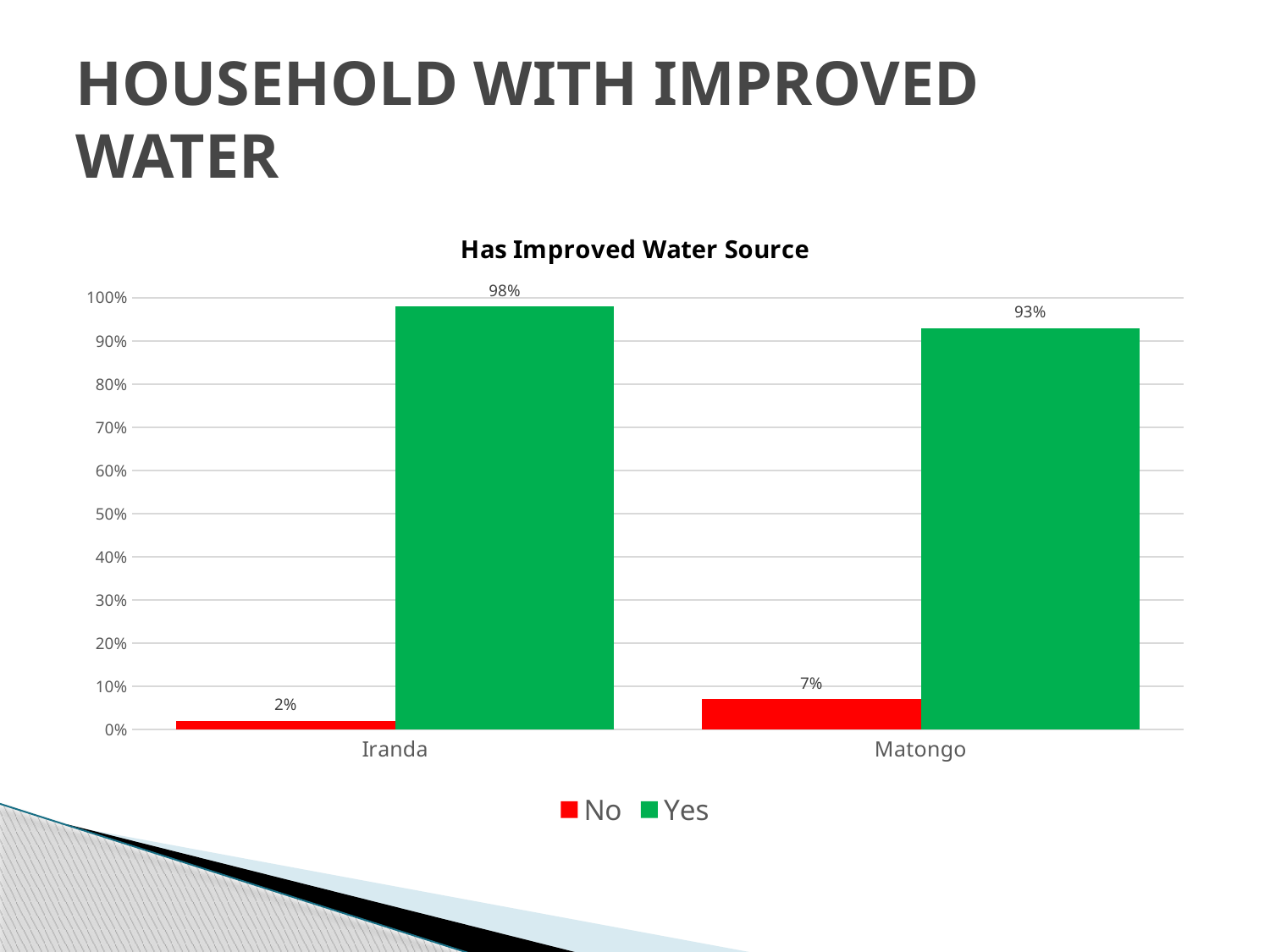
How many categories are shown on the x axis? 2 What is the difference between the Yes values for Iranda and Matongo? 5% What is the value of the Yes series for Iranda? 98% What type of chart is shown? bar chart What is the value of the No series for Matongo? 7% Is the No value for Matongo larger or smaller than the No value for Iranda? larger What is the value of the No series for Iranda? 2% Which category has the lower No value? Iranda What is the value of the Yes series for Matongo? 93% How many series does the legend list? 2 Which category has the higher Yes value? Iranda Is the Yes value for Matongo greater or less than 90%? greater